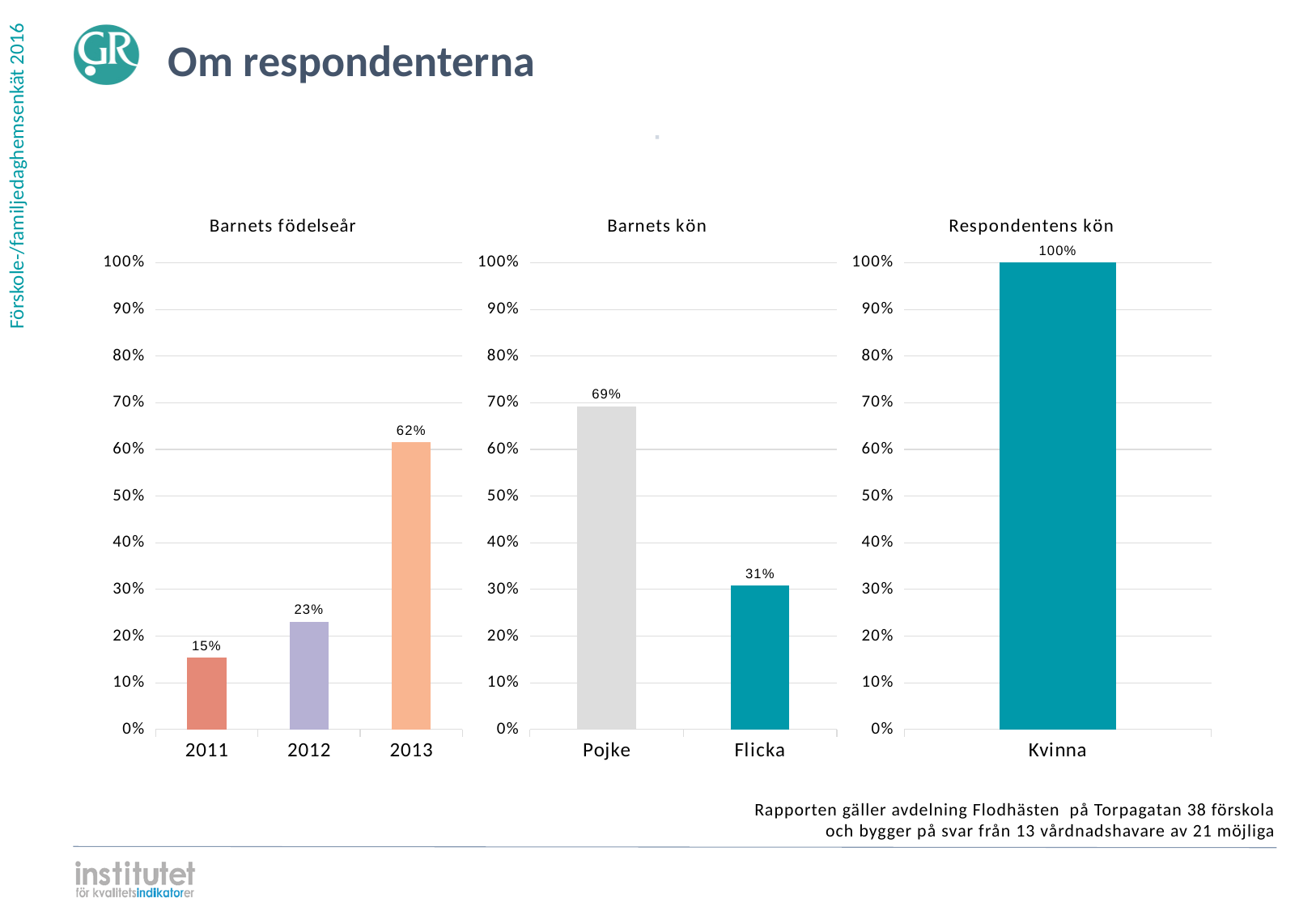
In the 'Barnets kön' chart, what is the difference between Pojke and Flicka? 38 percentage points In the 'Barnets födelseår' chart, which year has the lowest value? 2011 In the 'Barnets kön' chart, what is the value for Pojke? 69% What kind of chart is the 'Barnets kön' chart? bar chart What is the title of the leftmost chart on the slide? Barnets födelseår In the 'Barnets födelseår' chart, what is the difference between the values for 2013 and 2012? 39 percentage points In the 'Barnets födelseår' chart, do the values rise or fall from 2011 to 2013? rise In the 'Barnets födelseår' chart, what is the value for 2013? 62% In the 'Respondentens kön' chart, what is the value for Kvinna? 100% In the 'Respondentens kön' chart, how many categories are shown? 1 In the 'Barnets kön' chart, which is larger, Pojke or Flicka? Pojke In the 'Barnets födelseår' chart, how many categories are shown? 3